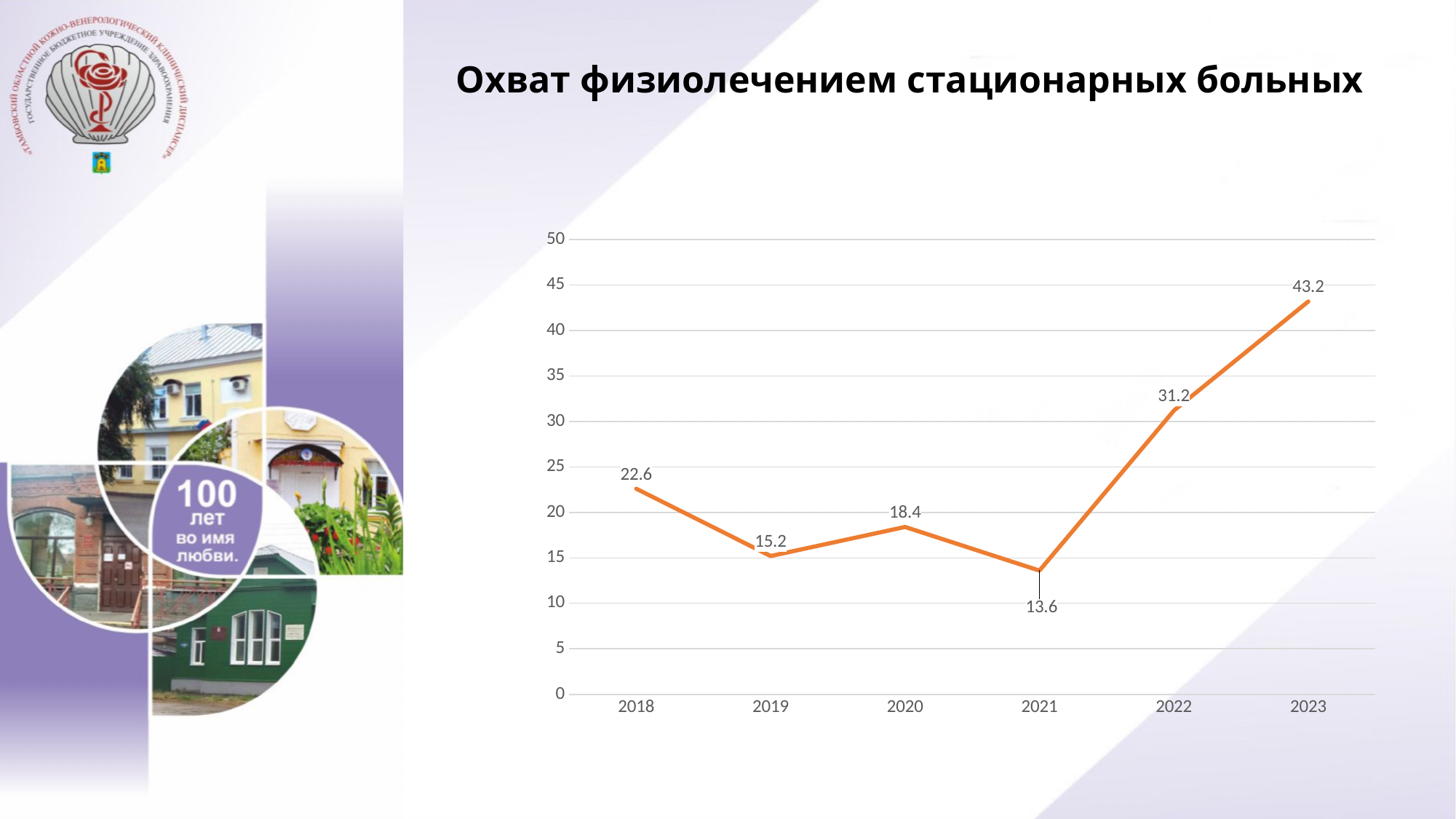
Which year has the highest value? 2023 How many years are plotted on the chart? 6 What is the difference between the values for 2023 and 2022? 12 Which year has the lowest value? 2021 What is the difference between the values for 2018 and 2019? 7.4 What is the title of the chart? Охват физиолечением стационарных больных What kind of chart is shown on the slide? line chart Is the value for 2022 greater or less than 30? greater What is the value for 2021? 13.6 Which is larger, the value for 2020 or the value for 2019? 2020 What is the value for 2018? 22.6 What is the value for 2023? 43.2